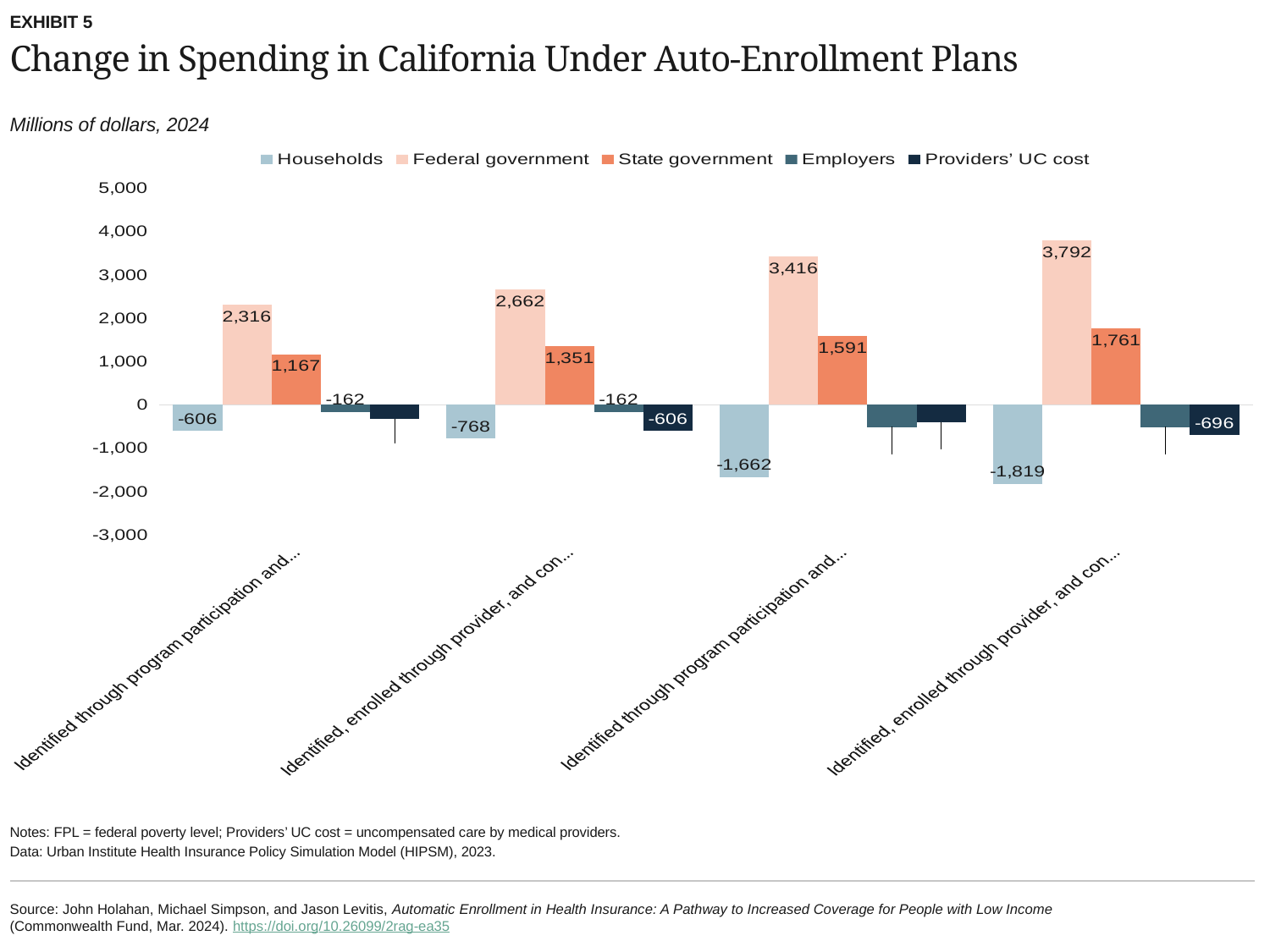
Is the value for Employers in the third group of bars greater or less than -1,000? greater What is the value for Providers' UC cost in the fourth group of bars from the left? -696 What kind of chart is shown on the slide? Bar chart In which group of bars is the Federal government value highest? The fourth group from the left (3,792) How many series does the legend list? 5 Do the Federal government values rise or fall moving from the first group to the fourth group along the x axis? Rise Which is larger, the State government value in the third group or in the fourth group? The fourth group (1,761) In which group of bars is the Households value lowest? The fourth group from the left (-1,819) What is the value for Households in the fourth group of bars from the left? -1,819 What is the difference between the Federal government values in the second and first groups of bars? 346 What is the value for Federal government in the first group of bars from the left? 2,316 What is the value for State government in the second group of bars from the left? 1,351